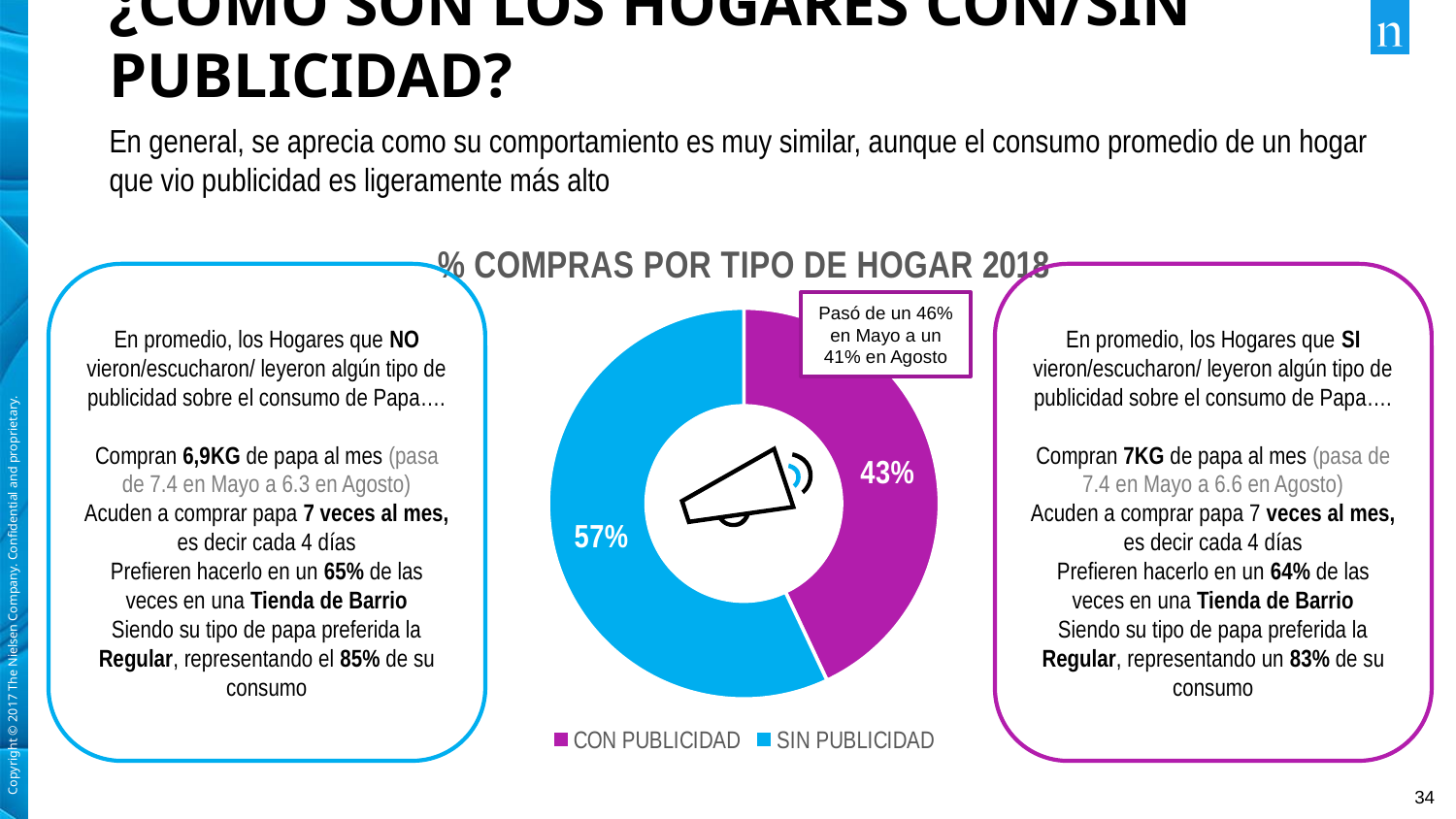
What is the value for CON PUBLICIDAD in the chart? 43% How many entries does the chart legend list? 2 Which colour represents CON PUBLICIDAD in the chart? Magenta (purple) How many categories does the chart show? 2 What share of the chart does SIN PUBLICIDAD represent? 57% What is the value for SIN PUBLICIDAD in the chart? 57% Which category has the smallest share in the chart? CON PUBLICIDAD Which is larger, the share for CON PUBLICIDAD or for SIN PUBLICIDAD? SIN PUBLICIDAD What is the title of the chart? % COMPRAS POR TIPO DE HOGAR 2018 What kind of chart is shown on the slide? Donut (pie) chart Which category has the largest share in the chart? SIN PUBLICIDAD What is the difference between the SIN PUBLICIDAD and CON PUBLICIDAD shares? 14%